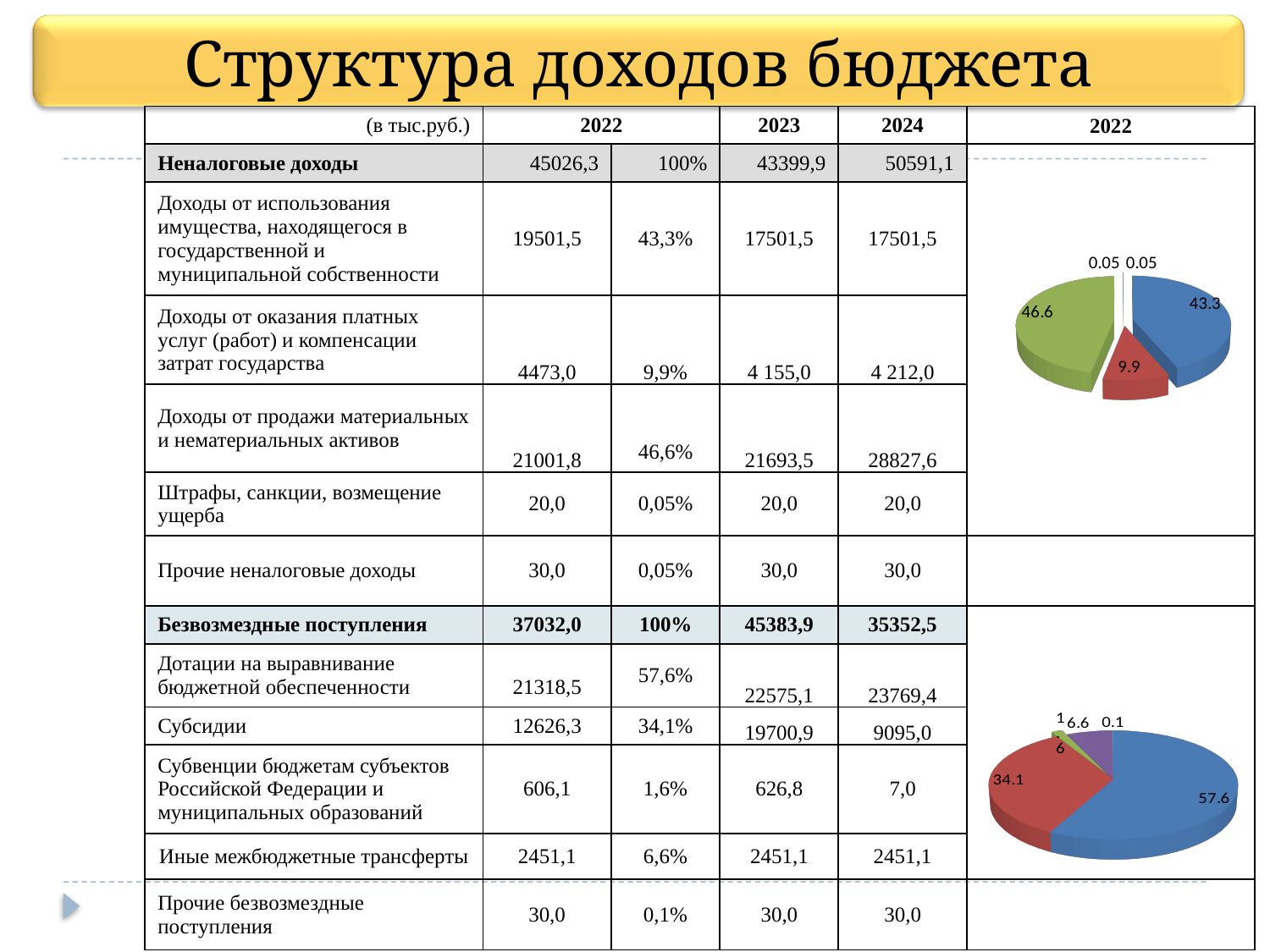
In the top pie chart, what value is labelled on the blue slice? 43.3 In the top pie chart, how many slices are there? 5 In the top pie chart, what is the difference between the green slice (46.6) and the blue slice (43.3)? 3.3 In the bottom pie chart, what is the value of the smallest slice? 0.1 In the bottom pie chart, what value is labelled on the red slice? 34.1 In the top pie chart, what is the value of the largest slice? 46.6 What kind of charts are shown on the right side of the slide? Pie charts In the top pie chart, what value is labelled on the red slice? 9.9 In the bottom pie chart, which slice is larger, the blue one or the red one? The blue one (57.6) In the bottom pie chart, what is the value of the largest slice? 57.6 In the bottom pie chart, how many slices are there? 5 Which year is shown in the column header above the pie charts? 2022